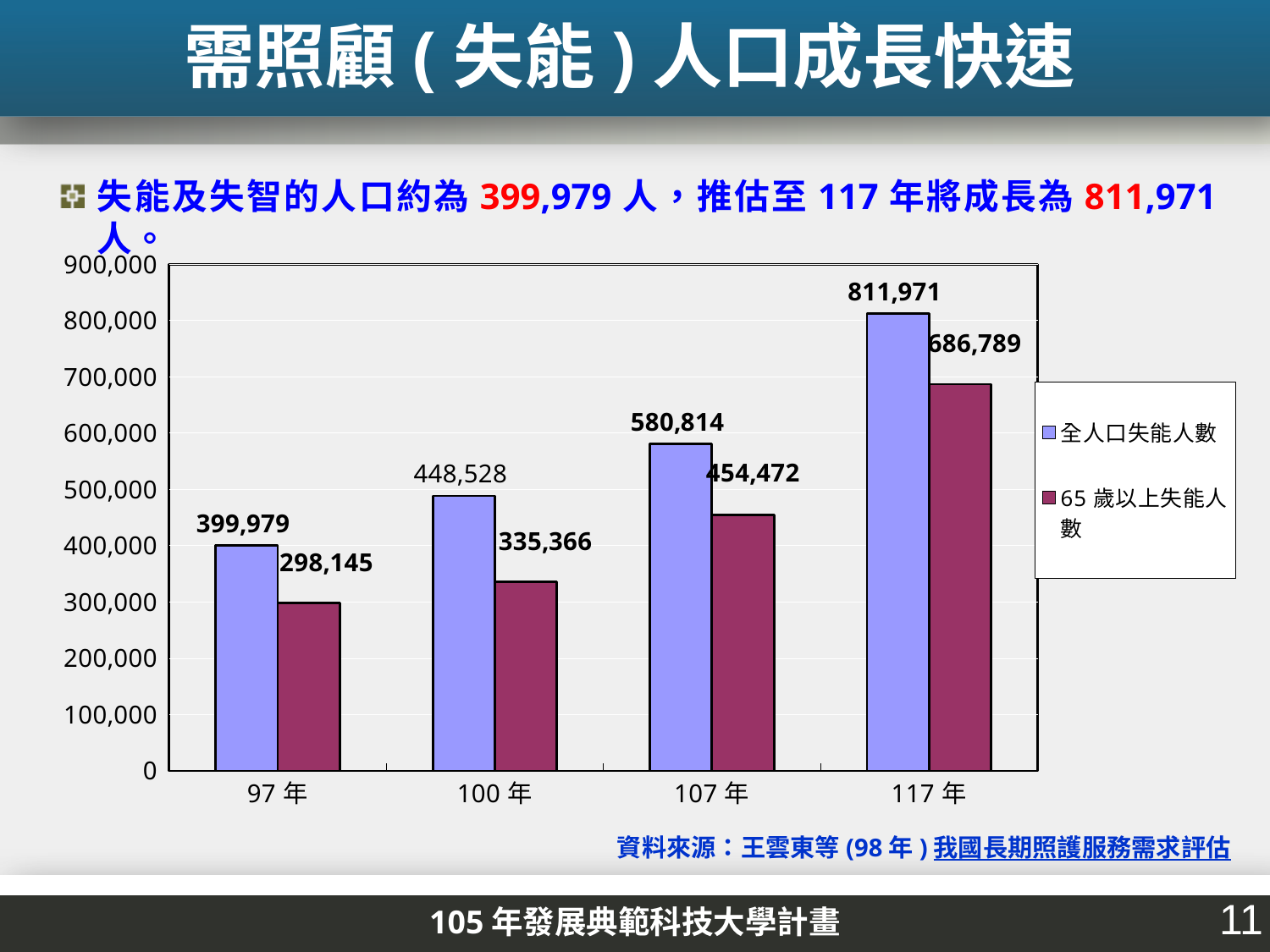
What is the difference between 全人口失能人數 and 65 歲以上失能人數 for 117 年? 125,182 How many year categories are shown on the x axis? 4 Is the value of 65 歲以上失能人數 for 100 年 greater or less than 400,000? less Does 全人口失能人數 rise or fall from 97 年 to 117 年? rise How many series does the legend list? 2 What is the value of 全人口失能人數 for 100 年? 448,528 What is the value of 全人口失能人數 for 97 年? 399,979 Which year has the lowest value for 65 歲以上失能人數? 97 年 What is the value of 65 歲以上失能人數 for 107 年? 454,472 What is the value of 65 歲以上失能人數 for 117 年? 686,789 Which is larger for 100 年: 全人口失能人數 or 65 歲以上失能人數? 全人口失能人數 Which year has the highest value for 全人口失能人數? 117 年